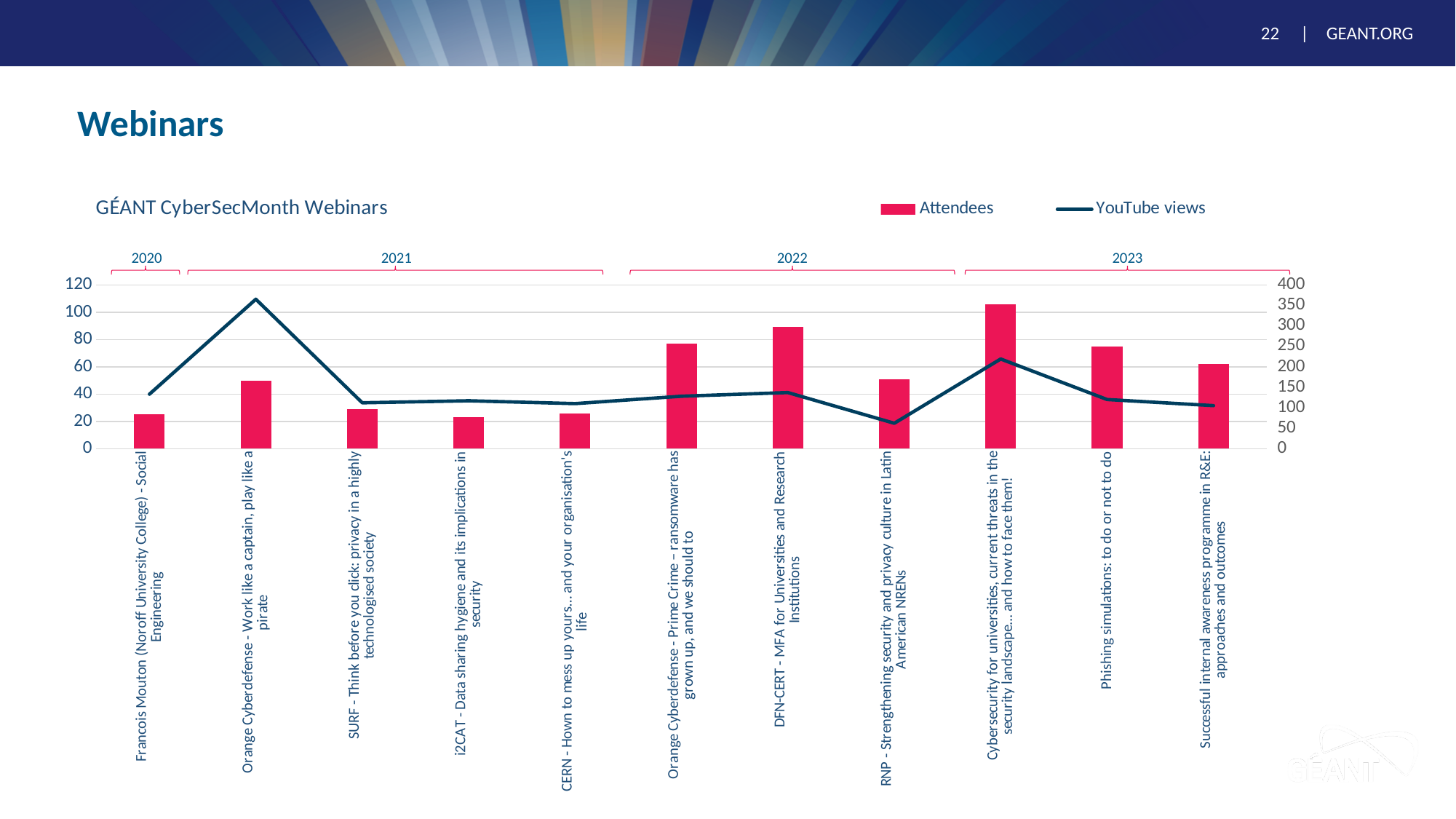
How many series does the legend list? 2 Which had more attendees: the DFN-CERT - MFA webinar or the Orange Cyberdefense - Prime Crime webinar? DFN-CERT - MFA for Universities and Research Institutions What kind of chart is shown on the slide? A combined bar and line chart Is the number of YouTube views for the Cybersecurity for universities webinar greater or less than 150? greater How many webinars (categories) are plotted on the x axis? 11 Which series is shown as a line in the chart? YouTube views Which webinar has the highest number of YouTube views? Orange Cyberdefense - Work like a captain, play like a pirate What is the title of the chart? GÉANT CyberSecMonth Webinars Is the number of attendees for the Phishing simulations: to do or not to do webinar greater or less than 60? greater Which webinar has the lowest number of YouTube views? RNP - Strengthening security and privacy culture in Latin American NRENs Which webinar has the highest number of attendees? Cybersecurity for universities, current threats in the security landscape... and how to face them! Is the number of attendees for the DFN-CERT - MFA for Universities and Research Institutions webinar greater or less than 80? greater